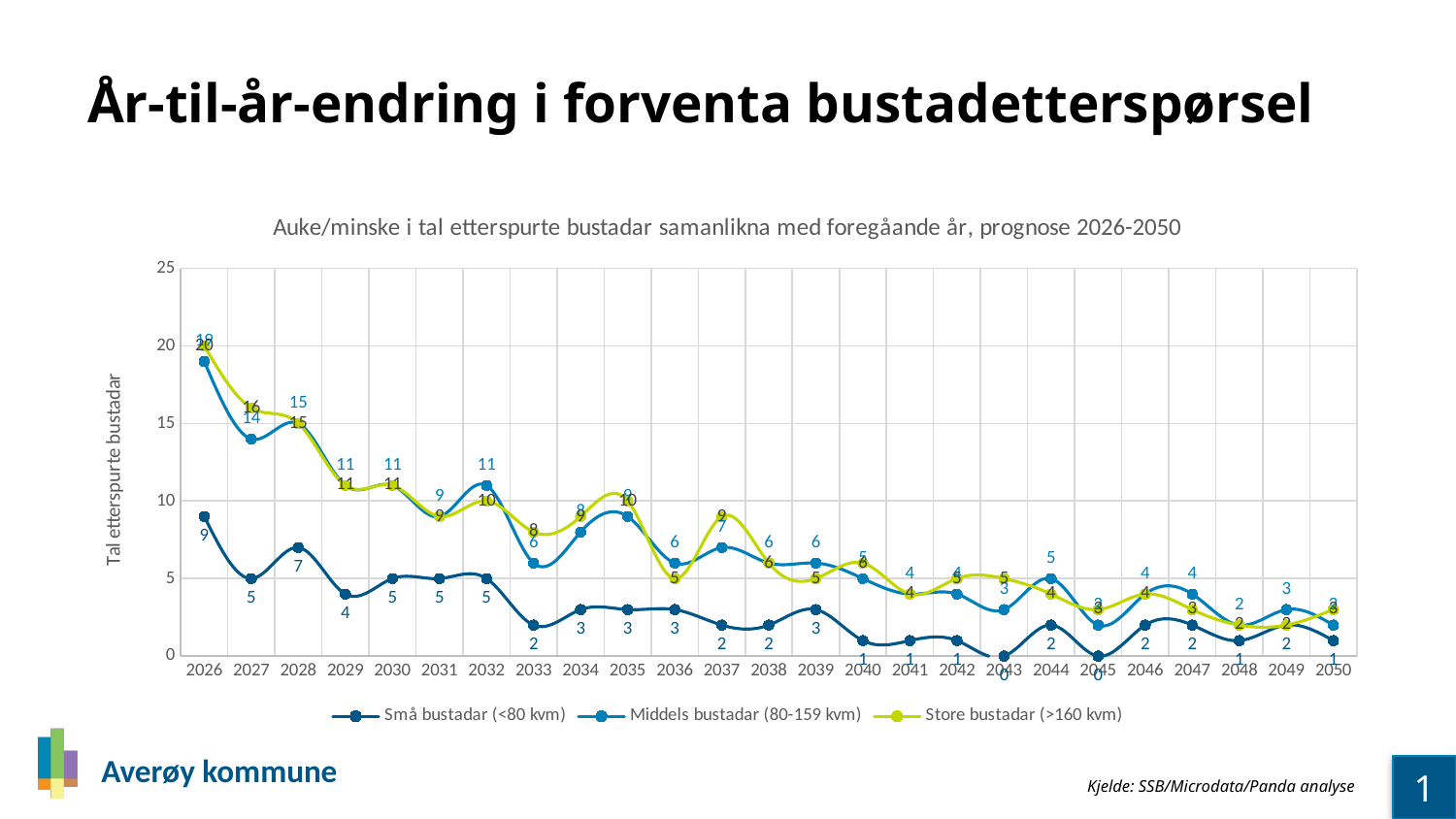
What is the lowest value plotted for Små bustadar (<80 kvm)? 0 Do the values for Middels bustadar (80-159 kvm) generally rise or fall from 2026 to 2050? Fall How many years are plotted along the x axis? 25 What is the value for Middels bustadar (80-159 kvm) in 2032? 11 In 2044, which series has the larger value: Middels bustadar (80-159 kvm) or Små bustadar (<80 kvm)? Middels bustadar (80-159 kvm) In which year is the value for Små bustadar (<80 kvm) highest? 2026 What is the value for Små bustadar (<80 kvm) in 2028? 7 Is the value for Middels bustadar (80-159 kvm) in 2026 greater or less than 15? greater How many series does the legend list? 3 In 2027, what is the difference between the value for Store bustadar (>160 kvm) and the value for Middels bustadar (80-159 kvm)? 2 What kind of chart is shown on the slide? Line chart What is the value for Store bustadar (>160 kvm) in 2037? 9